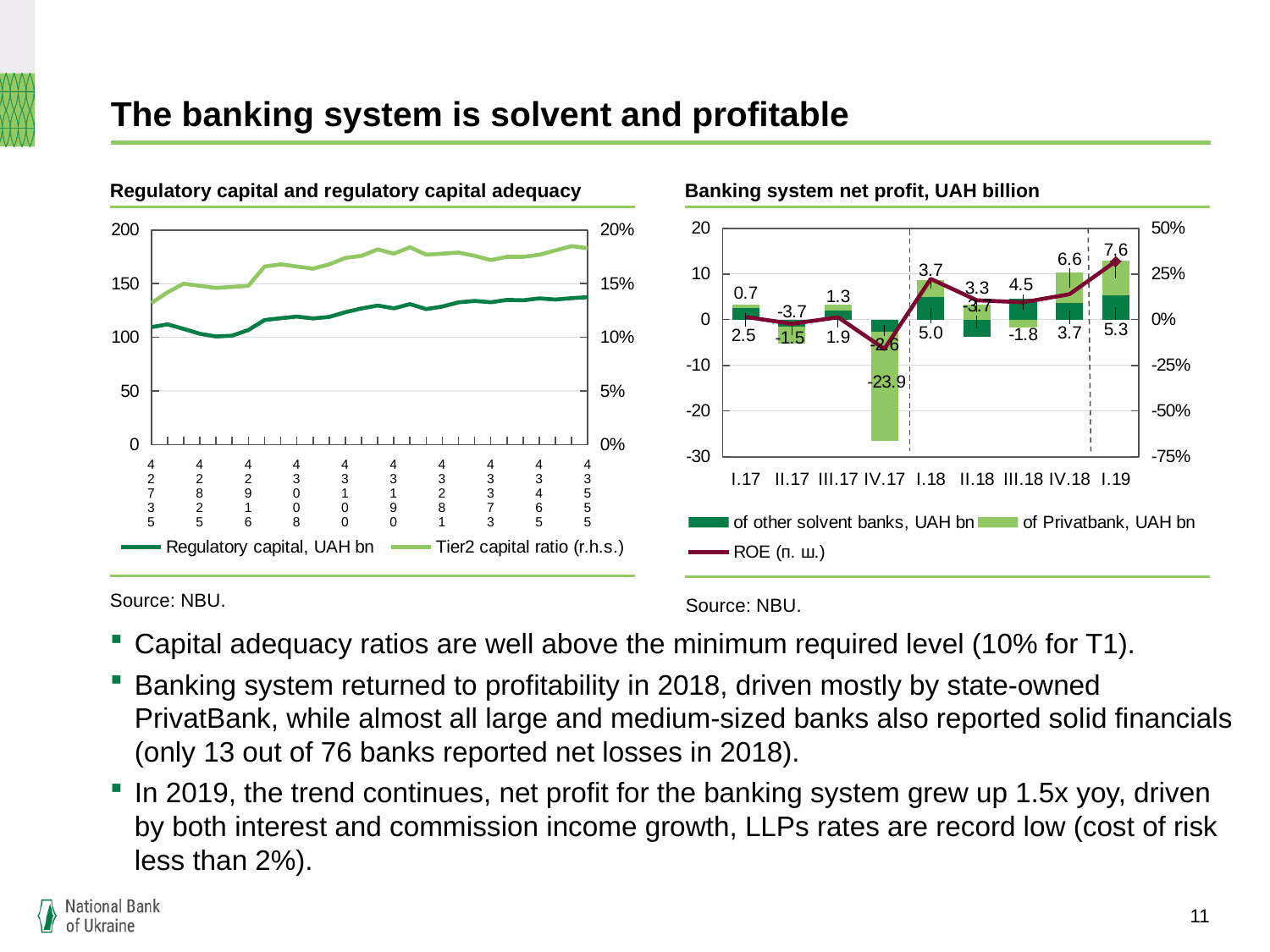
What kind of chart is the 'Regulatory capital and regulatory capital adequacy' chart? line chart How many quarters are shown on the x axis of the 'Banking system net profit, UAH billion' chart? 9 In the 'Banking system net profit, UAH billion' chart, what is the total net profit (other solvent banks plus Privatbank) in I.19? 12.9 What kind of chart is the 'Banking system net profit, UAH billion' chart? combination bar and line chart How many series does the legend of the 'Regulatory capital and regulatory capital adequacy' chart list? 2 In the 'Banking system net profit, UAH billion' chart, which is larger in I.18: the value for other solvent banks or the value for Privatbank? other solvent banks In the 'Banking system net profit, UAH billion' chart, what is the difference between the Privatbank values in I.19 and IV.18? 1.0 In the 'Banking system net profit, UAH billion' chart, what is the value for other solvent banks in I.19? 5.3 In the 'Banking system net profit, UAH billion' chart, what is the value for Privatbank in IV.17? -23.9 In the 'Banking system net profit, UAH billion' chart, in which quarter is the Privatbank value lowest? IV.17 In the 'Regulatory capital and regulatory capital adequacy' chart, is the Tier2 capital ratio at the right end of the chart greater or less than 15%? greater How many series does the legend of the 'Banking system net profit, UAH billion' chart list? 3